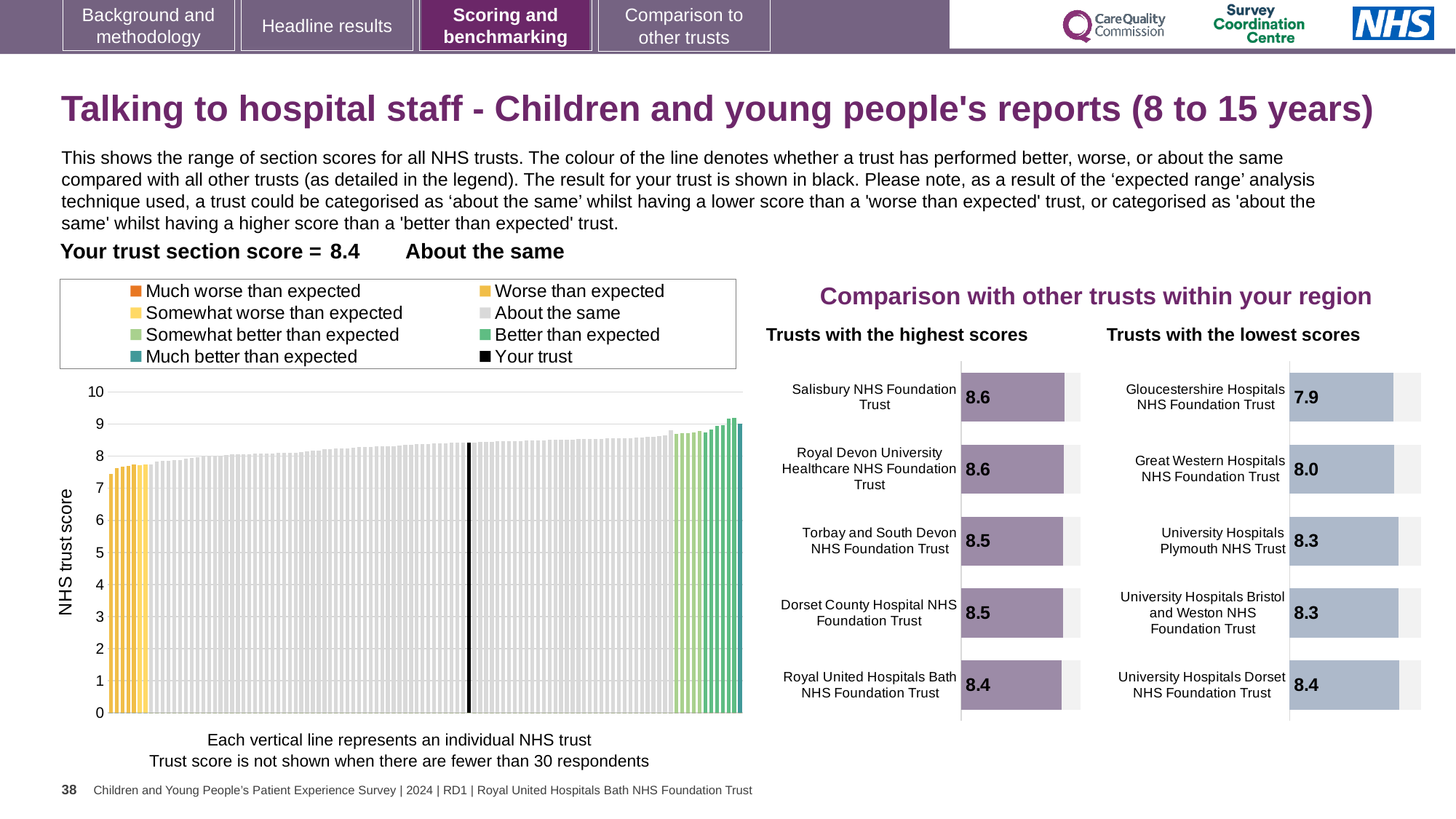
In the large chart on the left, do the trust scores rise or fall from left to right along the x axis? Rise How many trusts are shown in the 'Trusts with the lowest scores' chart? 5 In the 'Trusts with the highest scores' chart, which trust has the lowest score? Royal United Hospitals Bath NHS Foundation Trust In the 'Trusts with the highest scores' chart, what is the difference between the scores of Salisbury NHS Foundation Trust and Royal United Hospitals Bath NHS Foundation Trust? 0.2 In the 'Trusts with the highest scores' chart, what is the score for Torbay and South Devon NHS Foundation Trust? 8.5 In the 'Trusts with the highest scores' chart, what is the score for Salisbury NHS Foundation Trust? 8.6 How many entries does the legend above the large chart on the left list? 8 In the 'Trusts with the lowest scores' chart, which has the larger score: Great Western Hospitals NHS Foundation Trust or University Hospitals Plymouth NHS Trust? University Hospitals Plymouth NHS Trust In the 'Trusts with the lowest scores' chart, what is the difference between the scores of University Hospitals Dorset NHS Foundation Trust and Gloucestershire Hospitals NHS Foundation Trust? 0.5 In the 'Trusts with the lowest scores' chart, which trust has the highest score? University Hospitals Dorset NHS Foundation Trust In the 'Trusts with the lowest scores' chart, what is the score for Gloucestershire Hospitals NHS Foundation Trust? 7.9 What kind of chart is the large chart on the left showing NHS trust scores? Bar chart